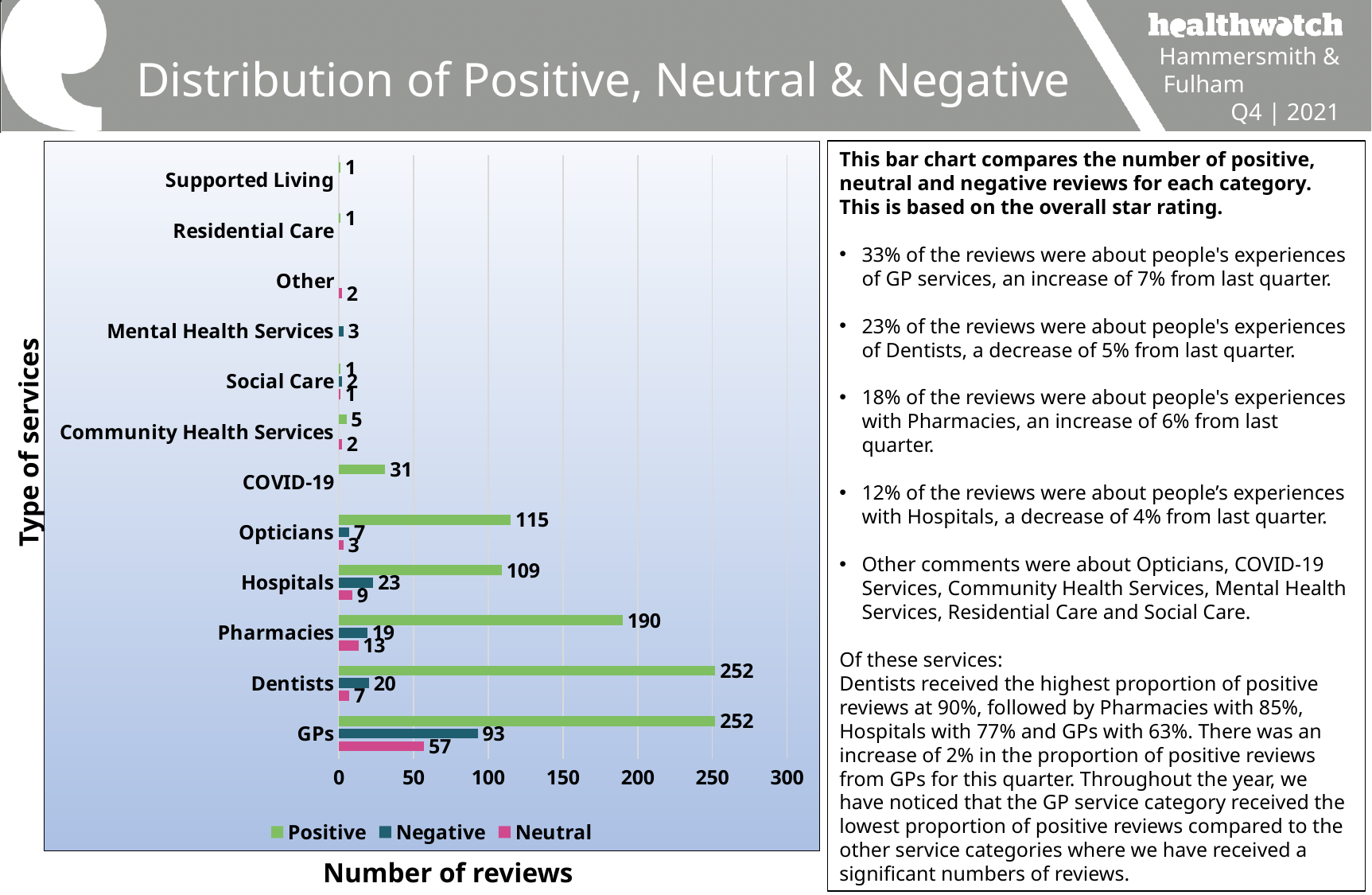
Which type of service has the highest number of negative reviews? GPs What kind of chart is shown on the slide? Bar chart How many positive reviews did Pharmacies receive? 190 Which type of service has the highest number of neutral reviews? GPs What is the total number of reviews (positive, negative and neutral) for GPs? 402 What is the difference between the positive reviews for Opticians and Hospitals? 6 How many negative reviews did GPs receive? 93 How many series does the legend list? 3 How many positive reviews did COVID-19 receive? 31 Which has more negative reviews, Dentists or Pharmacies? Dentists How many neutral reviews did Hospitals receive? 9 How many types of services are shown on the chart? 12